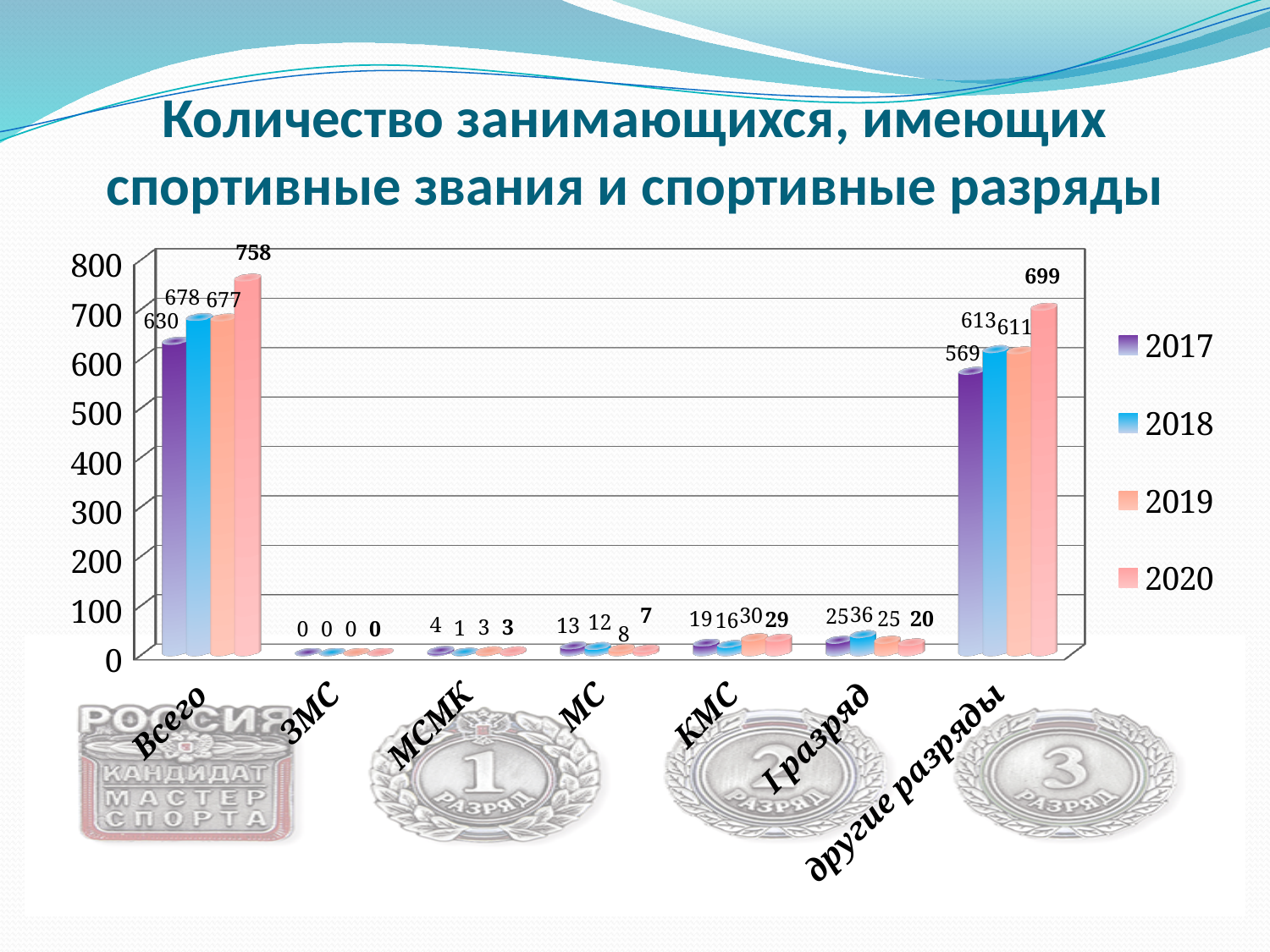
What is the difference between the 2020 and 2017 values for другие разряды? 130 What is the value for ЗМС in 2018? 0 What kind of chart is shown on the slide? Bar chart How many series does the legend list? 4 Which year has the highest value for Всего? 2020 Which year has the lowest value for МС? 2020 What is the value for I разряд in 2018? 36 Which is larger: the 2018 value for Всего or the 2019 value for Всего? 2018 (678) What is the value for КМС in 2019? 30 How many categories are shown on the x axis? 7 What is the value for Всего in 2020? 758 What is the value for другие разряды in 2017? 569